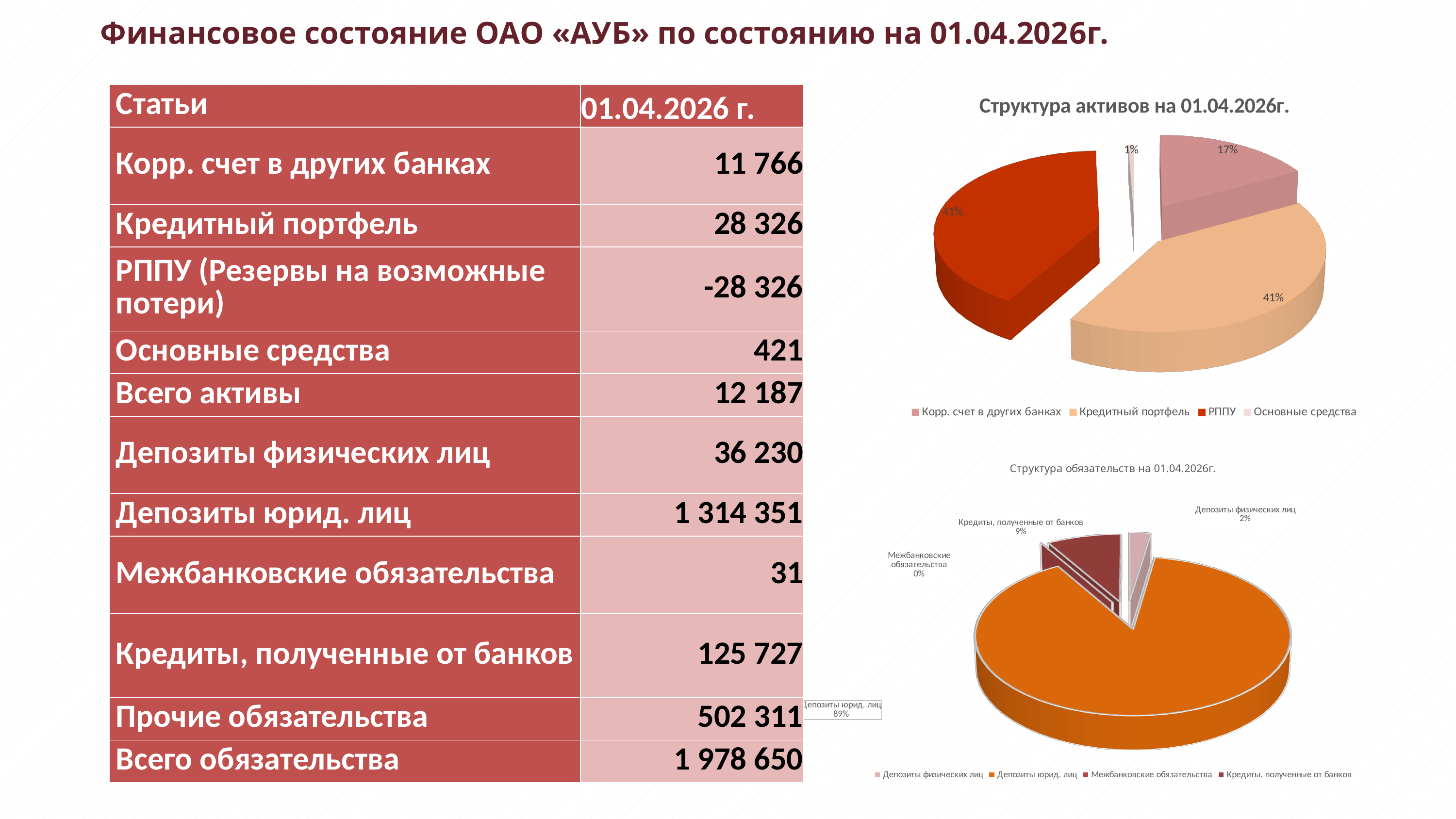
In the chart titled "Структура активов на 01.04.2026г.", what share does "Корр. счет в других банках" have? 17% In the chart titled "Структура активов на 01.04.2026г.", how many entries does the legend list? 4 In the chart titled "Структура обязательств на 01.04.2026г.", which category has the largest share? Депозиты юрид. лиц In the chart titled "Структура обязательств на 01.04.2026г.", what is the difference in percentage points between "Депозиты юрид. лиц" and "Кредиты, полученные от банков"? 80 In the chart titled "Структура обязательств на 01.04.2026г.", what share does "Кредиты, полученные от банков" have? 9% In the chart titled "Структура активов на 01.04.2026г.", what share does "Основные средства" have? 1% What kind of chart is the one titled "Структура активов на 01.04.2026г."? Pie chart In the chart titled "Структура обязательств на 01.04.2026г.", which is larger: "Кредиты, полученные от банков" or "Депозиты физических лиц"? Кредиты, полученные от банков In the chart titled "Структура активов на 01.04.2026г.", which category has the smallest share? Основные средства